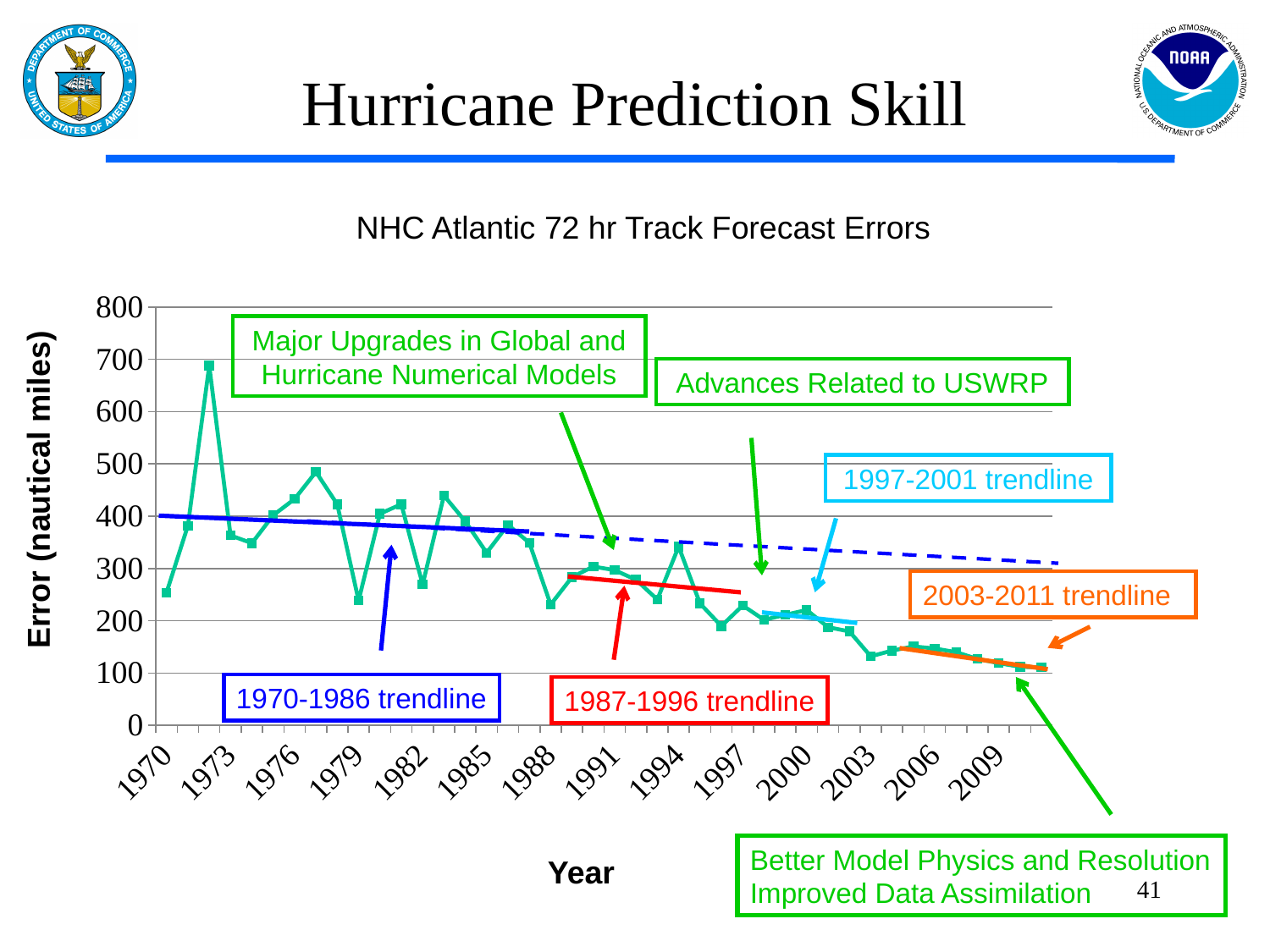
Is the forecast error for 1988 greater or less than 300 nautical miles? less Is the forecast error for 1970 greater or less than 300 nautical miles? less Is the forecast error for 2003 greater or less than 200 nautical miles? less What kind of chart is shown on the slide? line chart Which year has the larger forecast error, 1994 or 2003? 1994 What is the label on the vertical axis of the chart? Error (nautical miles) What is the title of the chart? NHC Atlantic 72 hr Track Forecast Errors Overall, do the forecast errors rise or fall from 1970 to 2011? fall Which year has the larger forecast error, 1970 or 1971? 1971 In which year is the 72 hr track forecast error highest? 1972